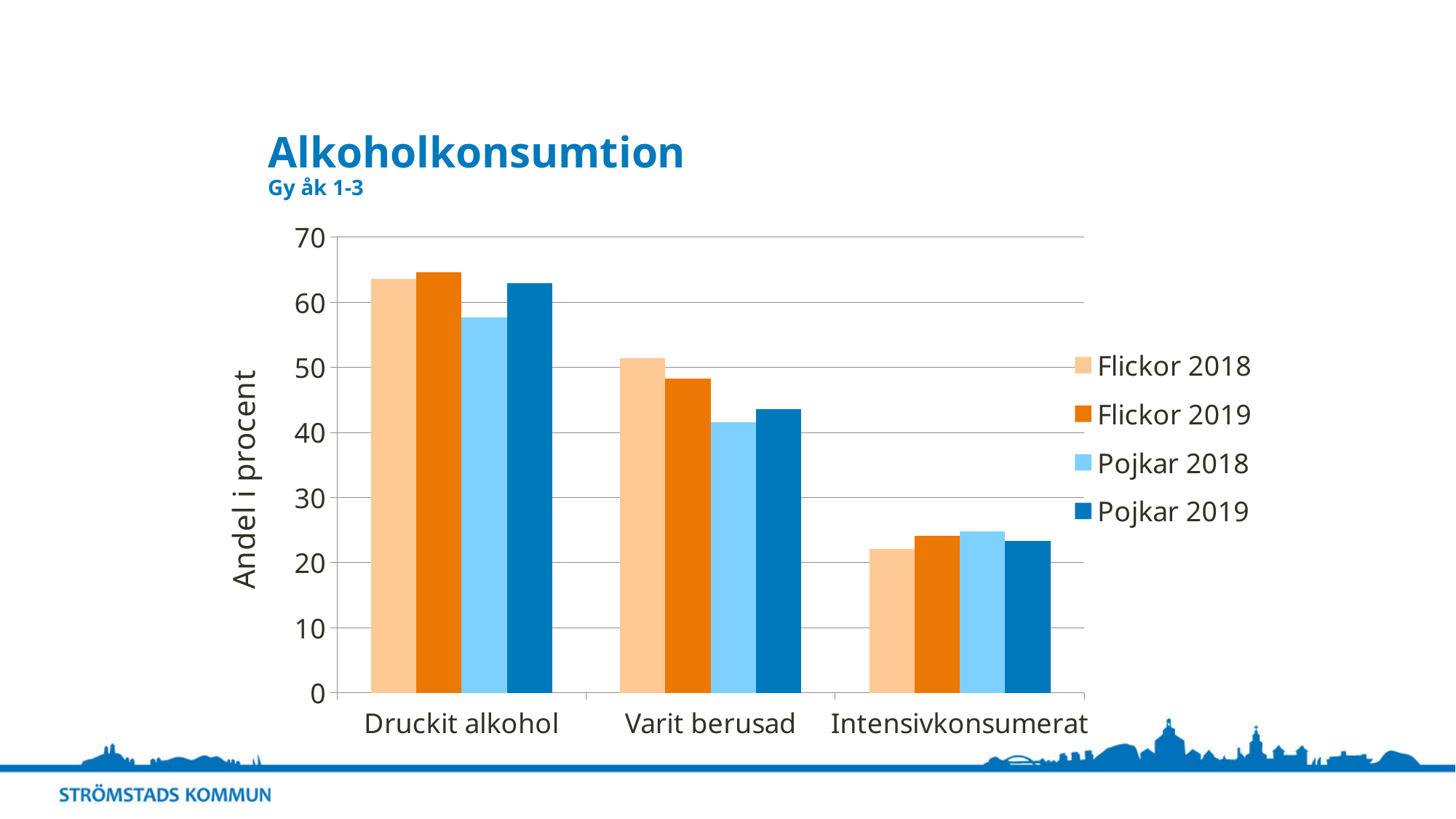
In the Druckit alkohol category, which is larger: Flickor 2019 or Pojkar 2018? Flickor 2019 How many series does the legend list? 4 Is the value for Flickor 2018 in the Intensivkonsumerat category greater or less than 30? less Which category has the highest value for Flickor 2019? Druckit alkohol Is the value for Pojkar 2018 in the Varit berusad category greater or less than 50? less Is the value for Flickor 2018 in the Druckit alkohol category greater or less than 60? greater What kind of chart is shown on the slide? bar chart How many categories are shown on the x axis of the chart? 3 In the Varit berusad category, which is larger: Flickor 2018 or Pojkar 2018? Flickor 2018 Which category has the lowest value for Pojkar 2019? Intensivkonsumerat What is the label on the vertical axis of the chart? Andel i procent